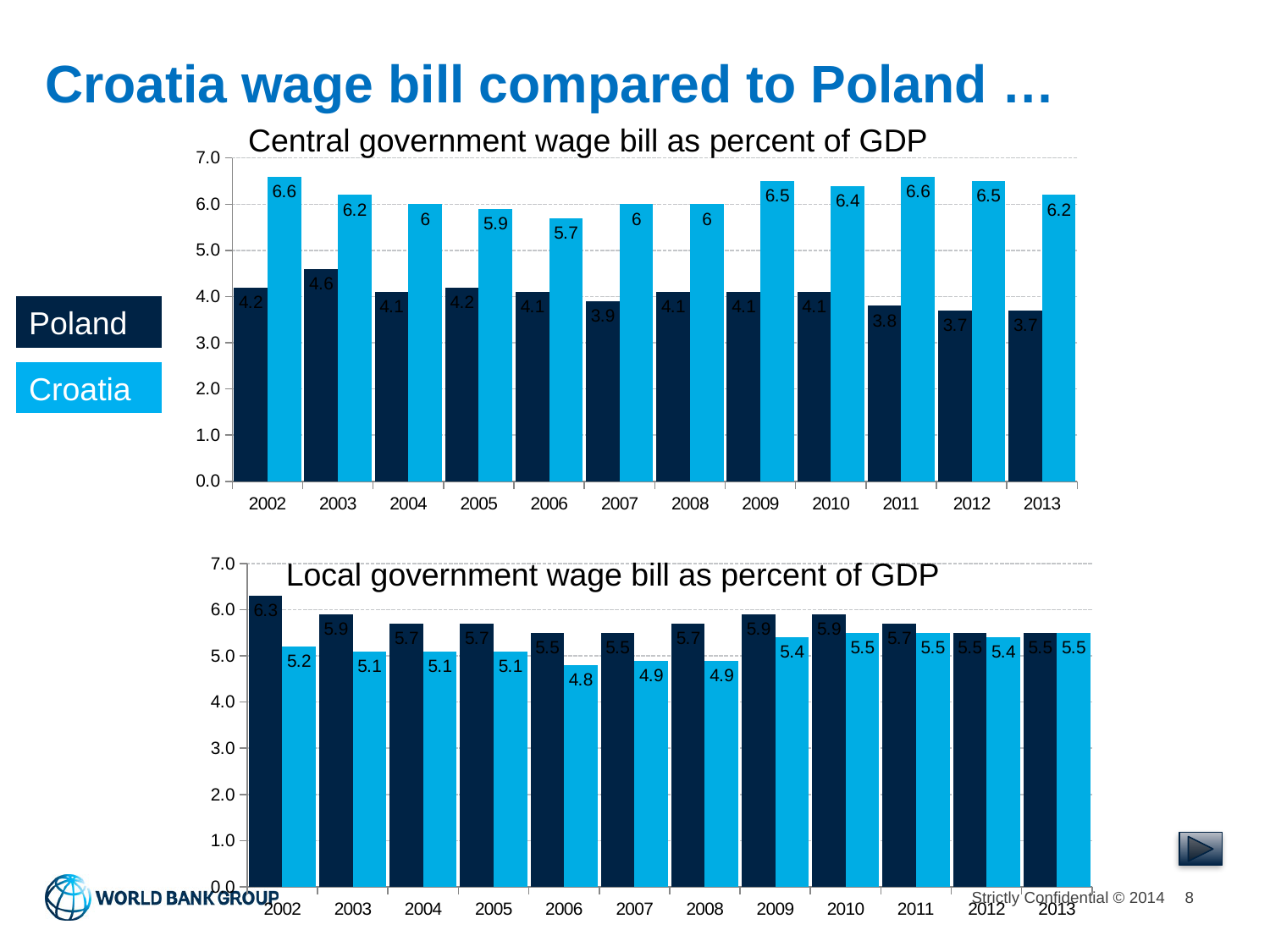
In the Central government wage bill chart, what is the difference between Croatia and Poland in 2013? 2.5 In the Local government wage bill chart, what is the value for Poland in 2002? 6.3 In the Central government wage bill chart, what is the value for Poland in 2007? 3.9 In the Local government wage bill chart, what is the value for Croatia in 2006? 4.8 Which colour represents Croatia in the charts? Light blue How many series does the legend list? 2 In the Local government wage bill chart, which year has the lowest value for Croatia? 2006 In the Central government wage bill chart, what is the value for Croatia in 2002? 6.6 In the Central government wage bill chart, which year has the highest value for Poland? 2003 In the Local government wage bill chart, which is larger in 2009, Poland or Croatia? Poland What type of chart is the Local government wage bill chart? Bar chart How many years are shown on the x axis of the Central government wage bill chart? 12